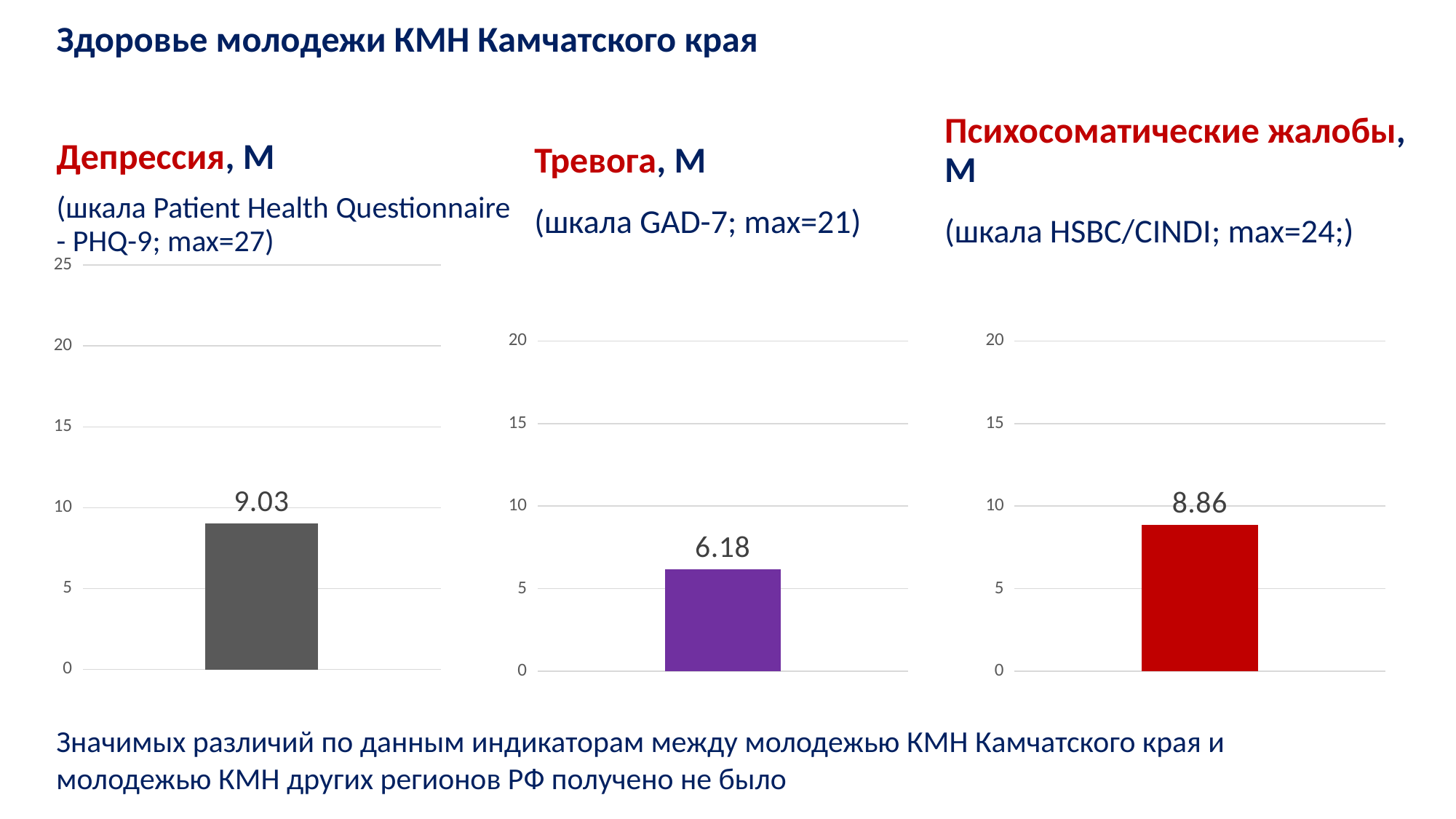
What colour is the bar in the "Психосоматические жалобы, М" chart? red In the "Депрессия, М" chart, what value is shown on the bar? 9.03 What is the difference between the value in the "Депрессия, М" chart and the value in the "Психосоматические жалобы, М" chart? 0.17 In the "Тревога, М" chart, is the bar value greater or less than 10? less What is the difference between the value in the "Психосоматические жалобы, М" chart and the value in the "Тревога, М" chart? 2.68 How many bars are plotted in the "Тревога, М" chart? 1 In the "Депрессия, М" chart, is the bar value greater or less than 5? greater What kind of chart is the "Депрессия, М" chart? bar chart In the "Психосоматические жалобы, М" chart, what value is shown on the bar? 8.86 In the "Тревога, М" chart, what value is shown on the bar? 6.18 Which is larger: the value in the "Депрессия, М" chart or the value in the "Тревога, М" chart? Депрессия, М What is the highest tick value on the vertical axis of the "Депрессия, М" chart? 25